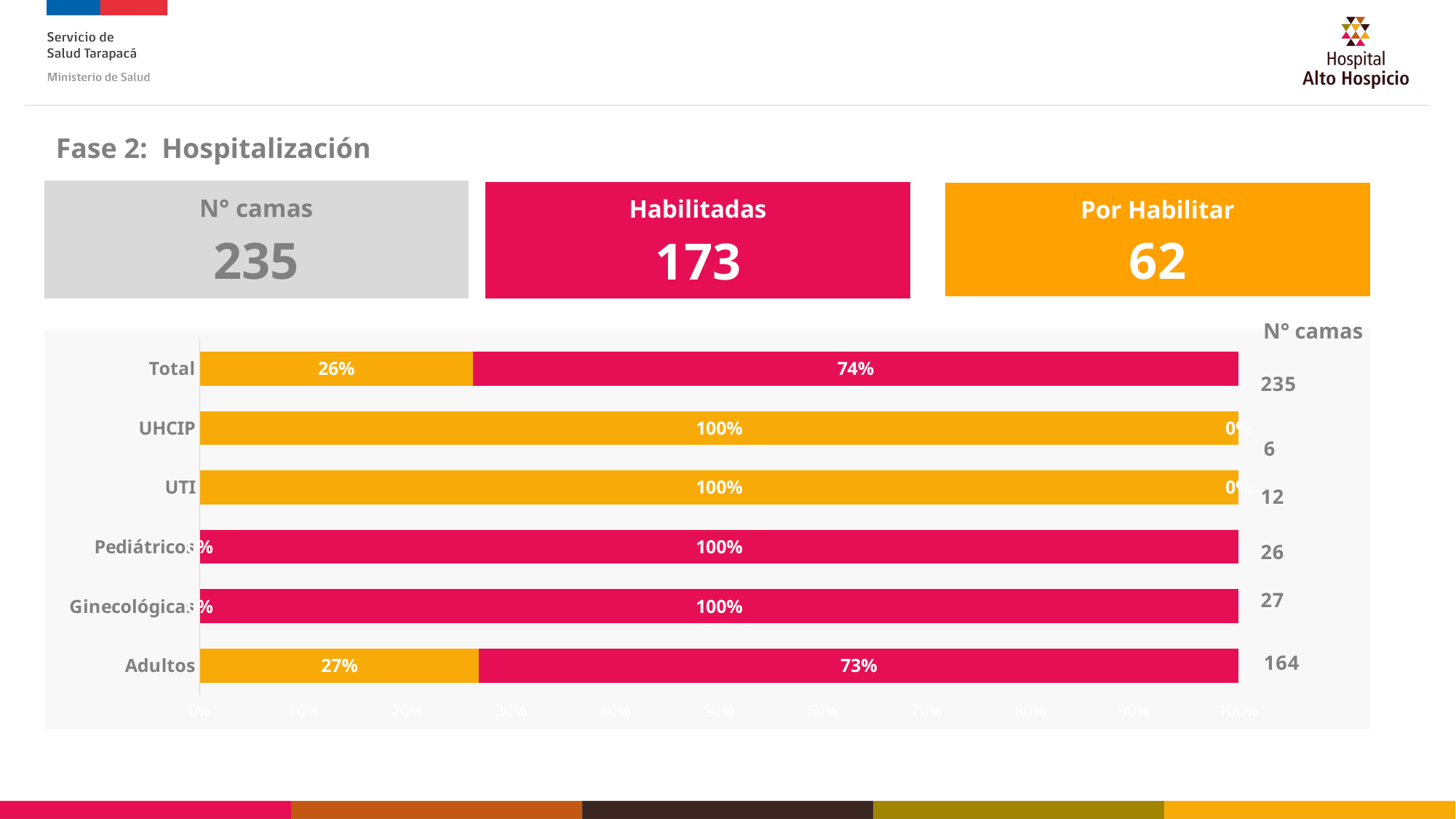
What is the pink (Habilitadas) percentage for Total? 74% What is the pink (Habilitadas) percentage for Ginecológicas? 100% What is the orange (Por Habilitar) percentage for UHCIP? 100% What is the N° camas value shown next to the UTI bar? 12 What is the orange (Por Habilitar) percentage for Total? 26% How many categories are shown on the chart's vertical axis? 6 What is the pink (Habilitadas) percentage for Adultos? 73% Which is larger for Adultos, the pink (Habilitadas) share or the orange (Por Habilitar) share? pink (Habilitadas), 73% What is the N° camas value shown next to the Adultos bar? 164 What is the difference between the pink and orange percentages for Total? 48% What is the orange (Por Habilitar) percentage for Adultos? 27% What kind of chart is shown on the slide? bar chart